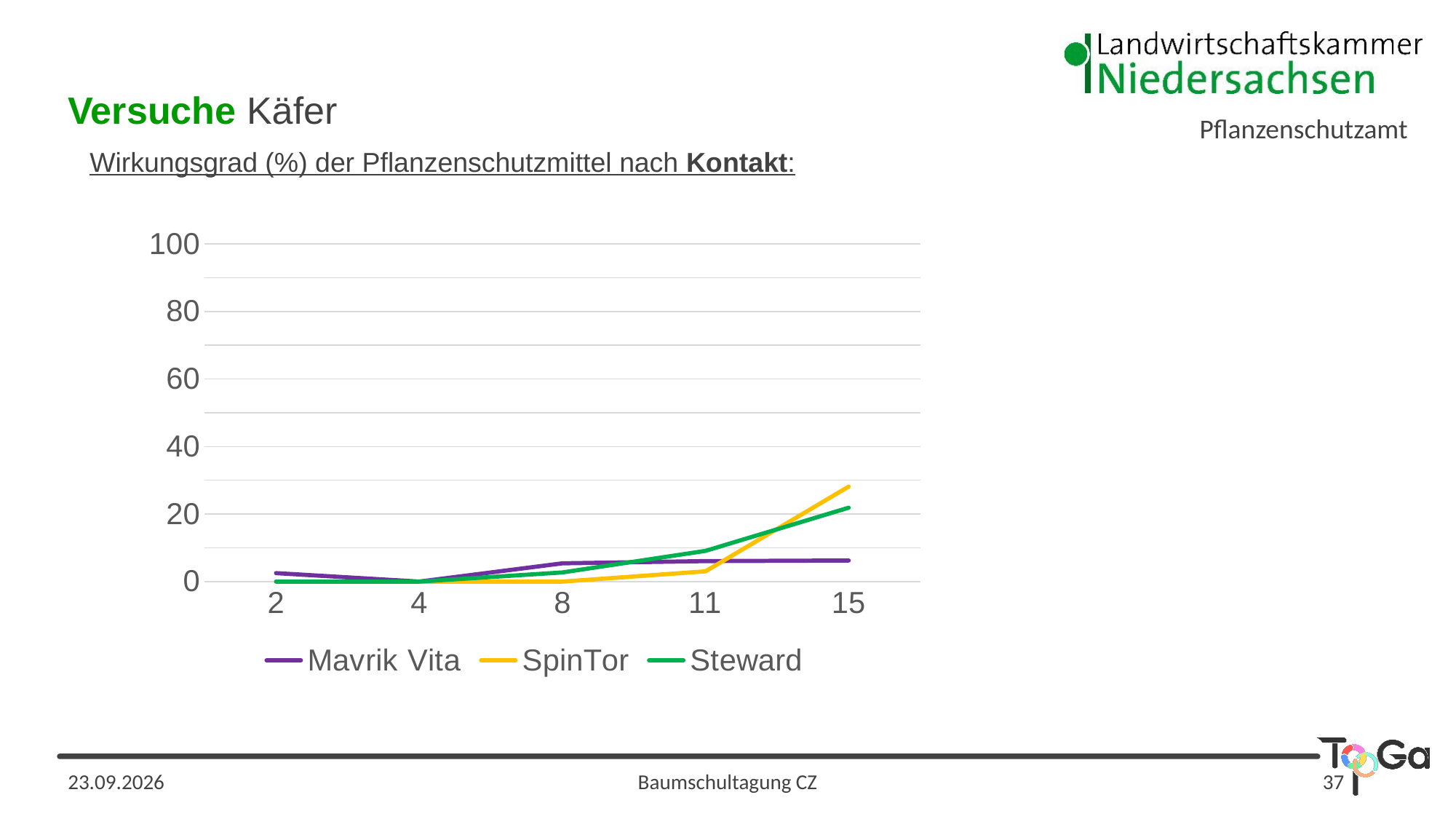
At x = 15, which is larger: the value for Steward or the value for Mavrik Vita? Steward How many series does the chart legend list? 3 Is the value for Mavrik Vita at x = 15 greater or less than 20? less Is the value for Steward at x = 15 greater or less than 40? less Which series is drawn in purple in the chart? Mavrik Vita What kind of chart is shown on the slide? line chart Does the SpinTor line rise or fall between x = 4 and x = 15? rise Is the value for SpinTor at x = 15 greater or less than 20? greater Which series has the lowest value at x = 15? Mavrik Vita What colour is the SpinTor line in the chart? yellow How many points are marked on the x axis of the chart? 5 Which series has the highest value at x = 15? SpinTor